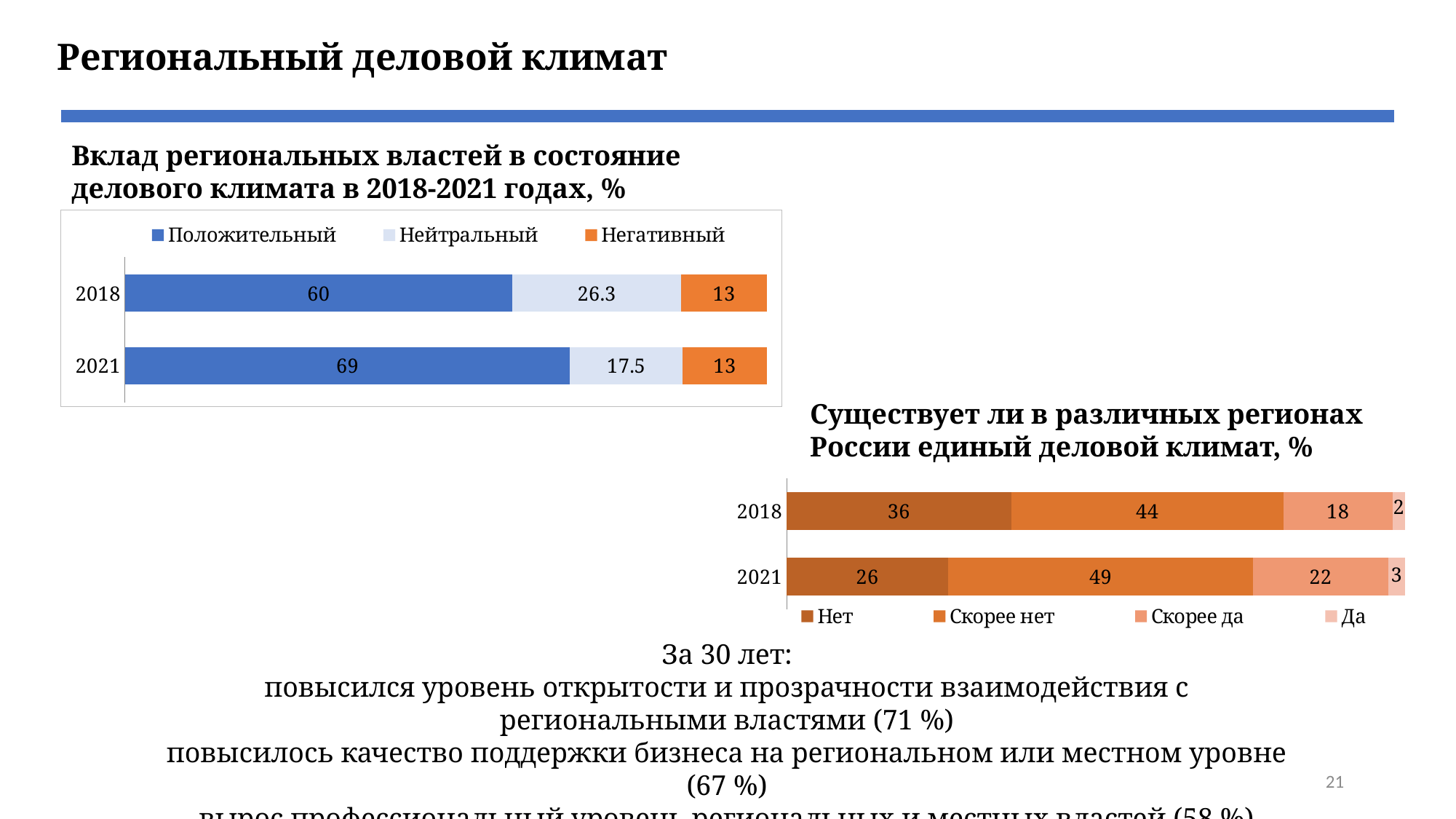
In the chart 'Вклад региональных властей в состояние делового климата в 2018-2021 годах, %', did the Нейтральный value rise or fall from 2018 to 2021? fall In the chart 'Вклад региональных властей в состояние делового климата в 2018-2021 годах, %', what is the value for Положительный in 2021? 69 In the chart 'Вклад региональных властей в состояние делового климата в 2018-2021 годах, %', by how much did the Положительный value change from 2018 to 2021? 9 In the chart 'Существует ли в различных регионах России единый деловой климат, %', what is the value for Скорее нет in 2021? 49 In the chart 'Вклад региональных властей в состояние делового климата в 2018-2021 годах, %', how many series does the legend list? 3 In the chart 'Существует ли в различных регионах России единый деловой климат, %', what is the value for Да in 2018? 2 In the chart 'Существует ли в различных регионах России единый деловой климат, %', which series has the lowest value in 2021? Да In the chart 'Вклад региональных властей в состояние делового климата в 2018-2021 годах, %', what is the value for Нейтральный in 2018? 26.3 In the chart 'Существует ли в различных регионах России единый деловой климат, %', what is the difference between the Нет values for 2018 and 2021? 10 In the chart 'Существует ли в различных регионах России единый деловой климат, %', which series has the highest value in 2018? Скорее нет In the chart 'Существует ли в различных регионах России единый деловой климат, %', how many series does the legend list? 4 What kind of chart is 'Существует ли в различных регионах России единый деловой климат, %'? stacked bar chart